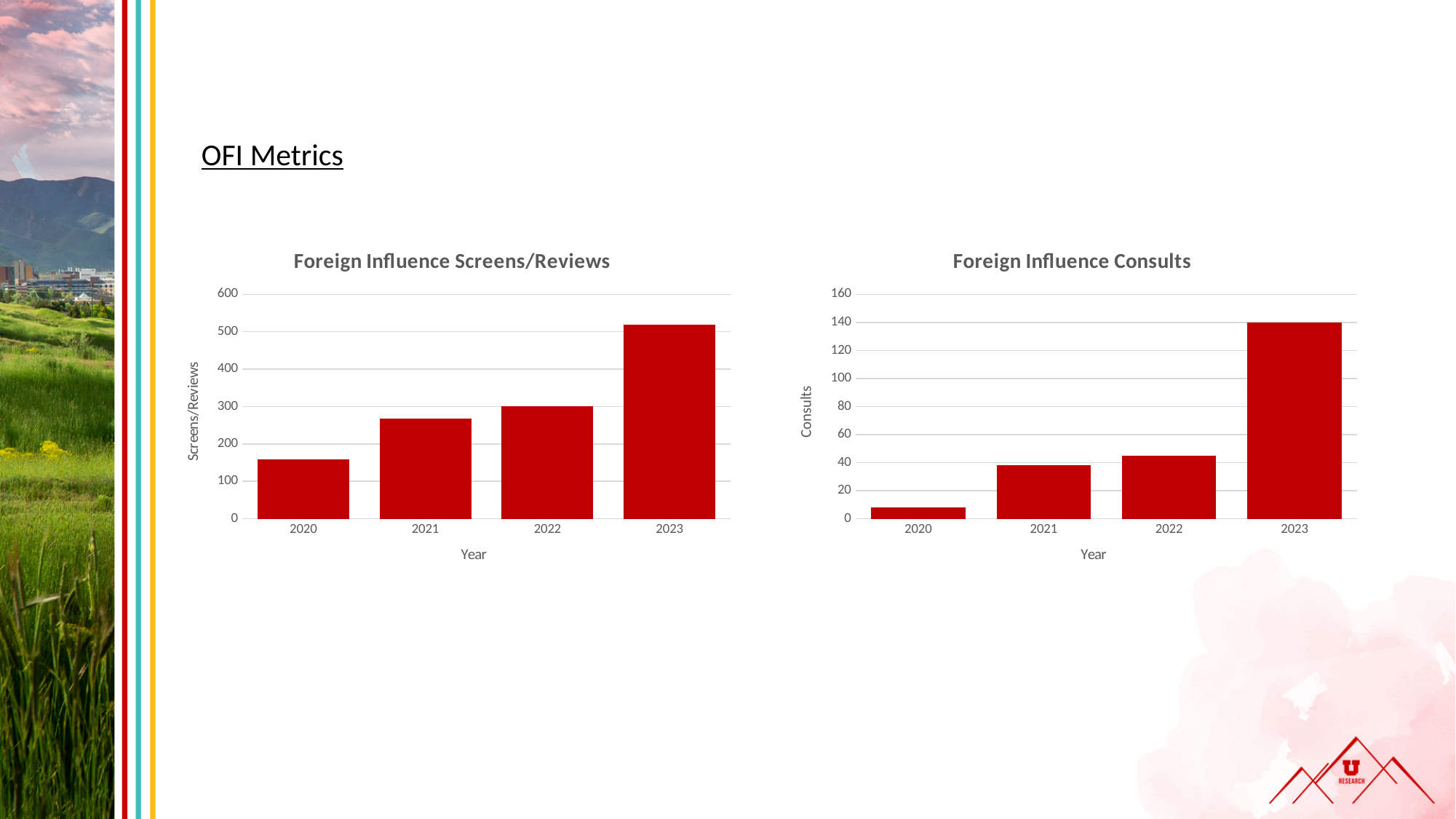
In the Foreign Influence Screens/Reviews chart, is the value for 2020 greater or less than 200? less In the Foreign Influence Consults chart, what is the label on the vertical axis? Consults In the Foreign Influence Screens/Reviews chart, which year has the highest value? 2023 In the Foreign Influence Screens/Reviews chart, which year has the lowest value? 2020 In the Foreign Influence Consults chart, is the value for 2023 greater or less than 120? greater In the Foreign Influence Screens/Reviews chart, do the values rise or fall from 2020 to 2023? rise In the Foreign Influence Screens/Reviews chart, how many years are shown on the x axis? 4 In the Foreign Influence Consults chart, is the value for 2020 greater or less than 20? less In the Foreign Influence Consults chart, which year has the lowest value? 2020 In the Foreign Influence Consults chart, which year has the highest value? 2023 What type of chart is the Foreign Influence Screens/Reviews chart? bar chart